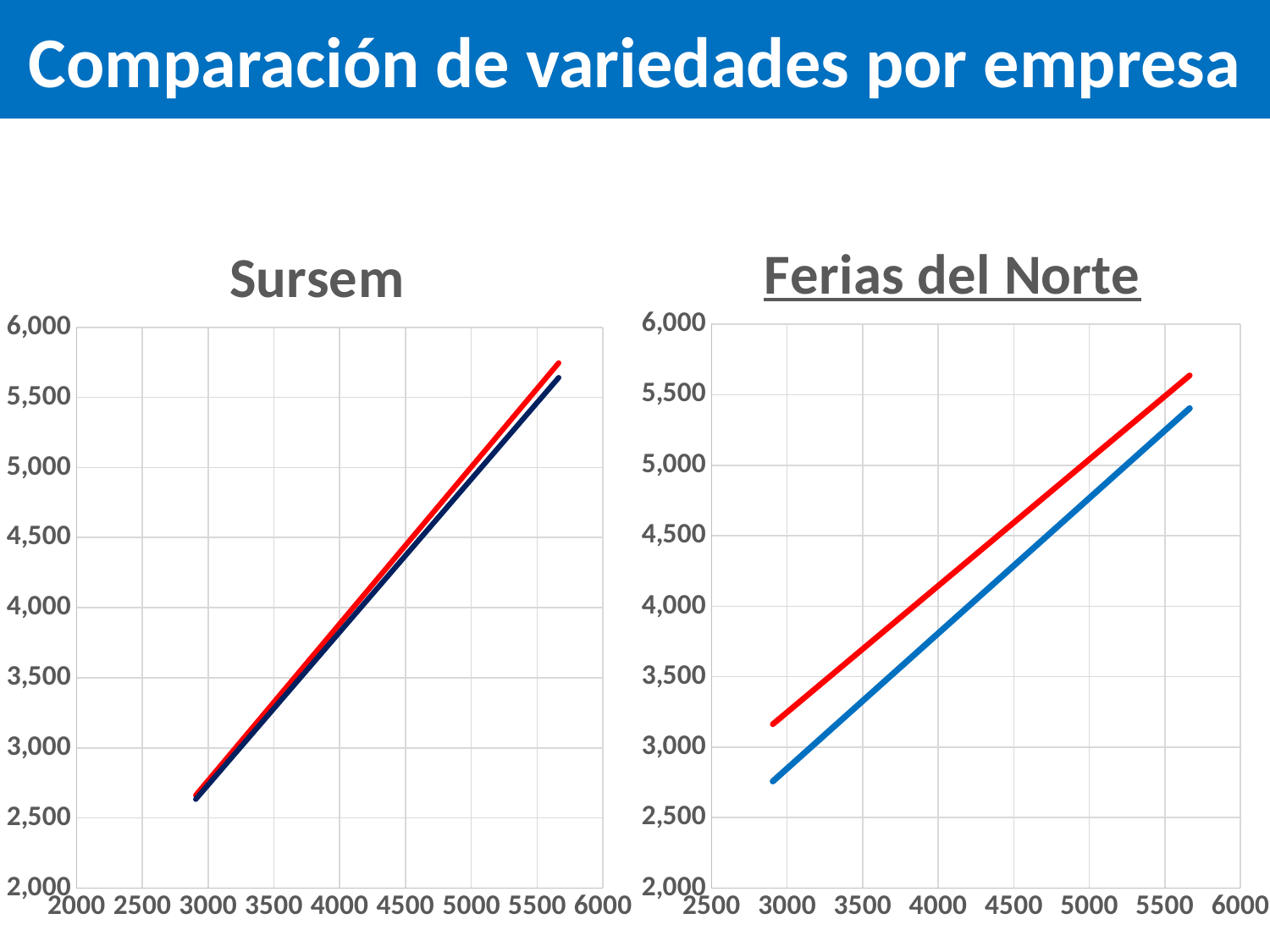
What is the title of the chart on the right side of the slide? Ferias del Norte In the Sursem chart, do the lines rise or fall from left to right? rise In the Ferias del Norte chart, which line is higher at x = 4000, the red line or the blue line? red line How many lines are plotted in the Ferias del Norte chart? 2 In the Ferias del Norte chart, do the lines rise or fall as the x-axis value increases? rise In the Ferias del Norte chart, is the value of the blue line at x = 5000 greater or less than 5,000? less How many lines are plotted in the Sursem chart? 2 What is the highest value labelled on the y-axis of the Sursem chart? 6,000 In the Sursem chart, is the value of the red line at x = 5500 greater or less than 5,000? greater In the Sursem chart, is the value of the red line at x = 3000 greater or less than 2,500? greater What kind of chart is the Sursem chart? line chart